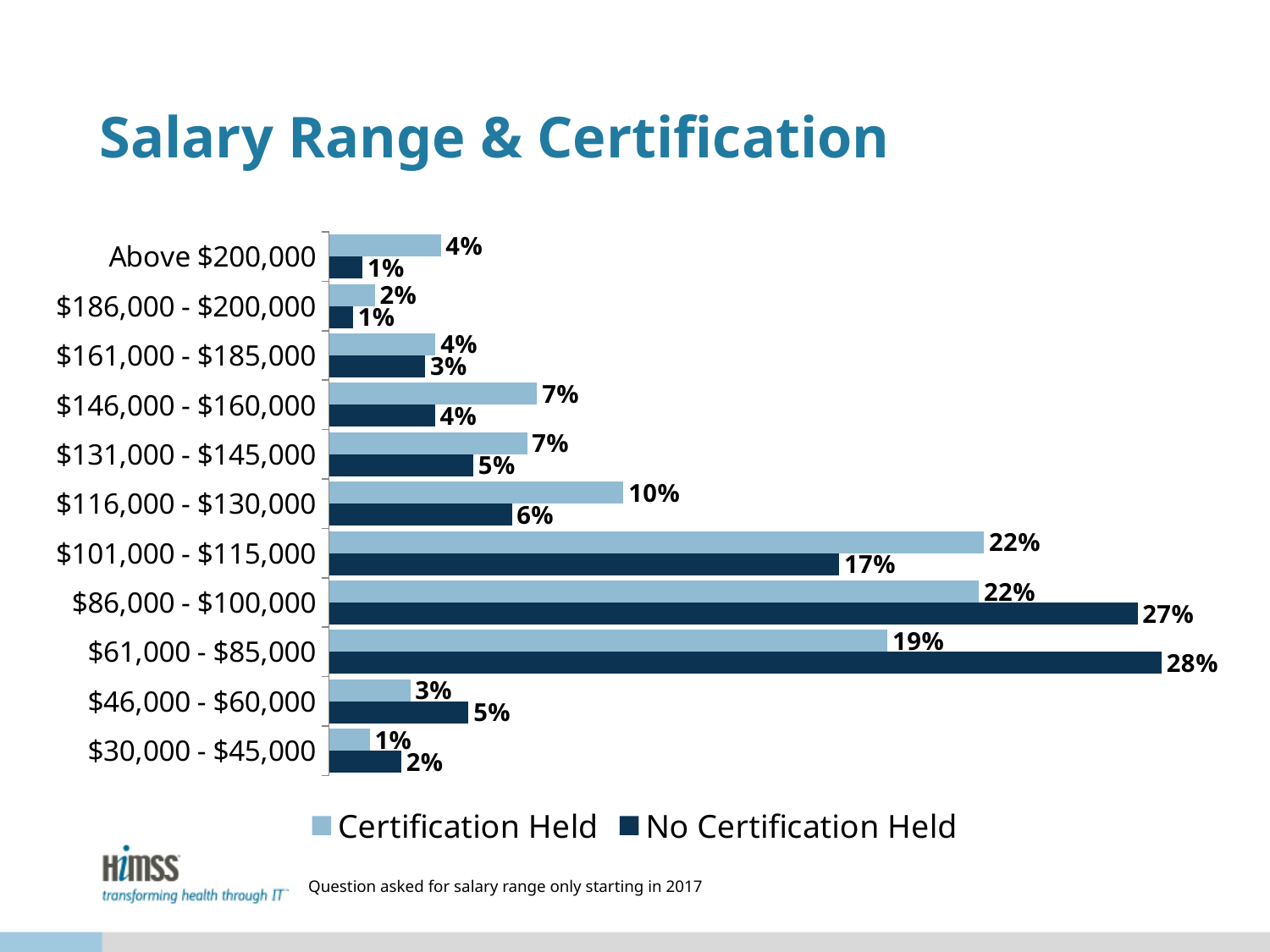
In the $46,000 - $60,000 range, which is larger: Certification Held or No Certification Held? No Certification Held In the $146,000 - $160,000 range, which is larger: Certification Held or No Certification Held? Certification Held Which salary range has the lowest value for Certification Held? $30,000 - $45,000 What percentage of respondents with no certification held earn $61,000 - $85,000? 28% How many series does the legend list? 2 Which salary range has the highest value for No Certification Held? $61,000 - $85,000 What type of chart is shown on the slide? Bar chart What is the title of the chart on the slide? Salary Range & Certification What is the difference between No Certification Held and Certification Held in the $86,000 - $100,000 range? 5% What is the value for Certification Held in the $116,000 - $130,000 range? 10% How many salary ranges are shown on the chart? 11 What percentage of respondents with a certification held earn $101,000 - $115,000? 22%